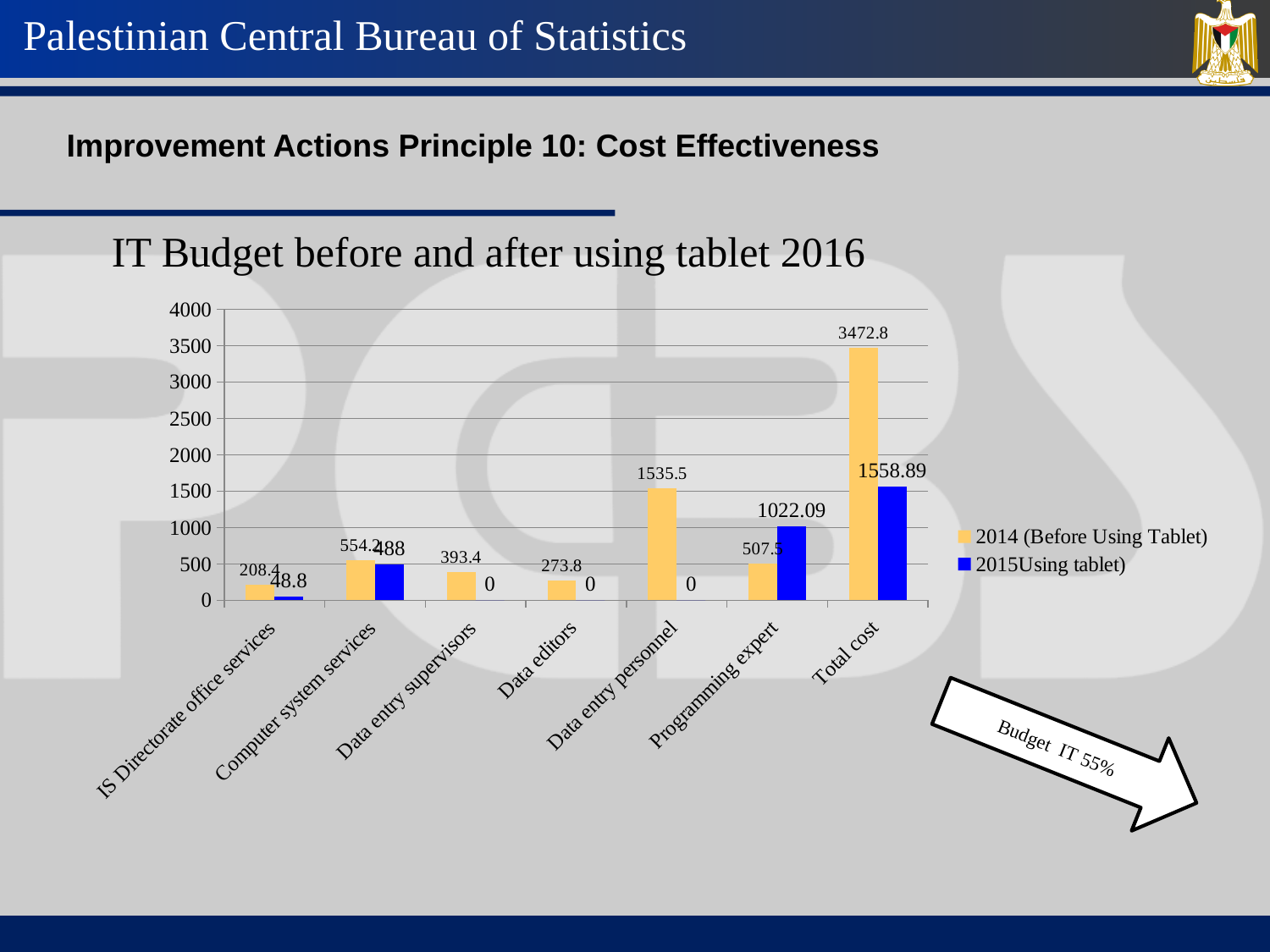
What kind of chart is shown on the slide? bar chart What is the 2015 (Using tablet) value for Total cost? 1558.89 What is the difference between the 2014 and 2015 values for Total cost? 1913.91 What is the 2015 (Using tablet) value for IS Directorate office services? 48.8 What is the 2015 (Using tablet) value for Data editors? 0 How many categories are shown on the x axis? 7 What is the 2014 (Before Using Tablet) value for Data entry personnel? 1535.5 Is the 2014 (Before Using Tablet) value for Data editors greater or less than 500? less What is the 2014 (Before Using Tablet) value for Total cost? 3472.8 Which category has the highest 2014 (Before Using Tablet) value? Total cost For Programming expert, which is larger: the 2014 (Before Using Tablet) value or the 2015 (Using tablet) value? 2015 (Using tablet) What is the 2015 (Using tablet) value for Programming expert? 1022.09